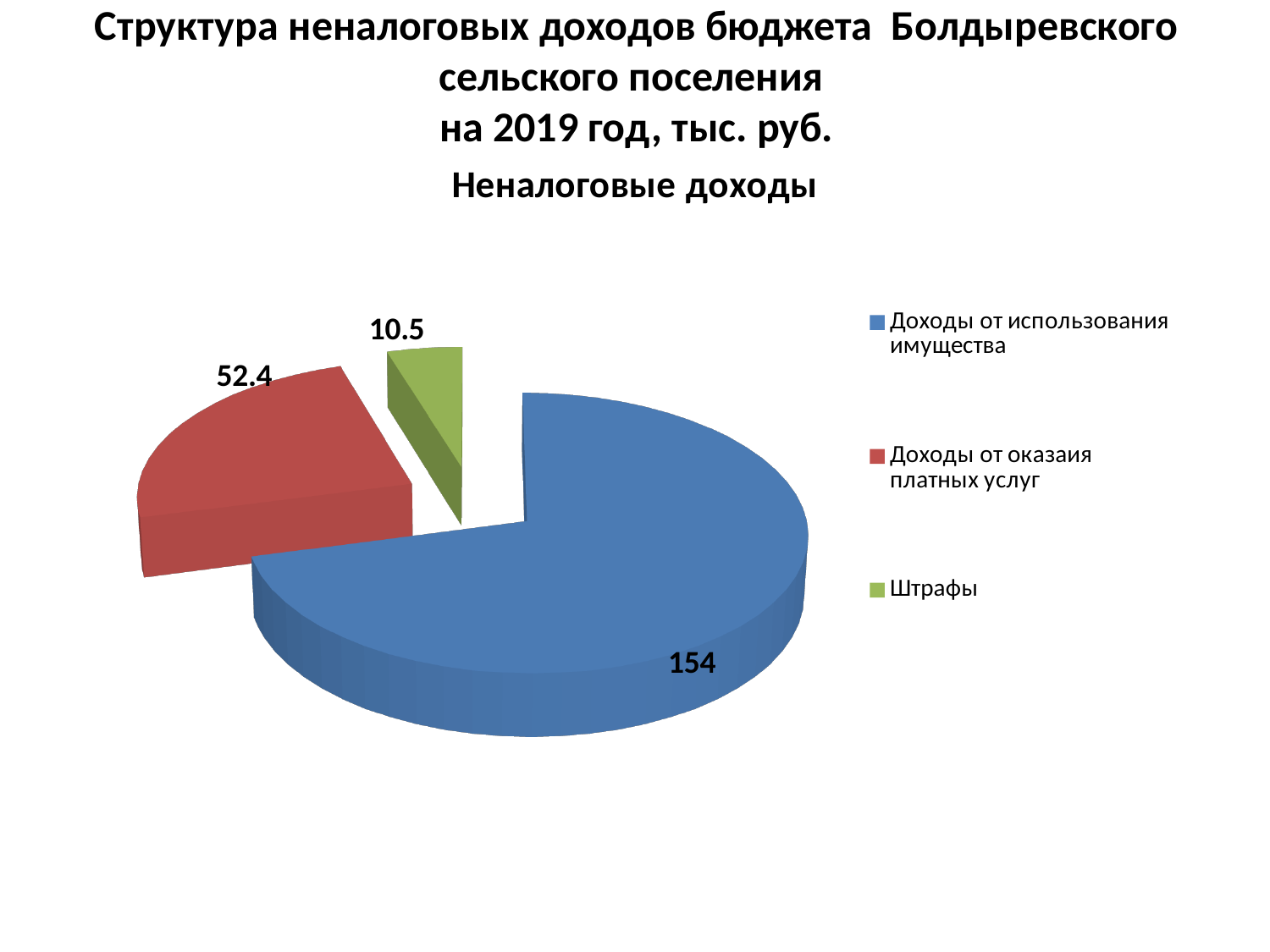
What is the difference between the value for Доходы от использования имущества and the value for Доходы от оказаия платных услуг? 101.6 What is the value for Штрафы? 10.5 What colour is the slice for Штрафы? green What kind of chart is shown on the slide? pie chart Which category has the smallest slice of the pie? Штрафы What is the total of all slices in the pie chart? 216.9 Which category has the largest slice of the pie? Доходы от использования имущества What is the value for Доходы от оказаия платных услуг? 52.4 How many slices does the pie chart have? 3 What is the difference between the value for Доходы от оказаия платных услуг and the value for Штрафы? 41.9 Which is larger: the value for Доходы от оказаия платных услуг or the value for Штрафы? Доходы от оказаия платных услуг What is the value for Доходы от использования имущества? 154